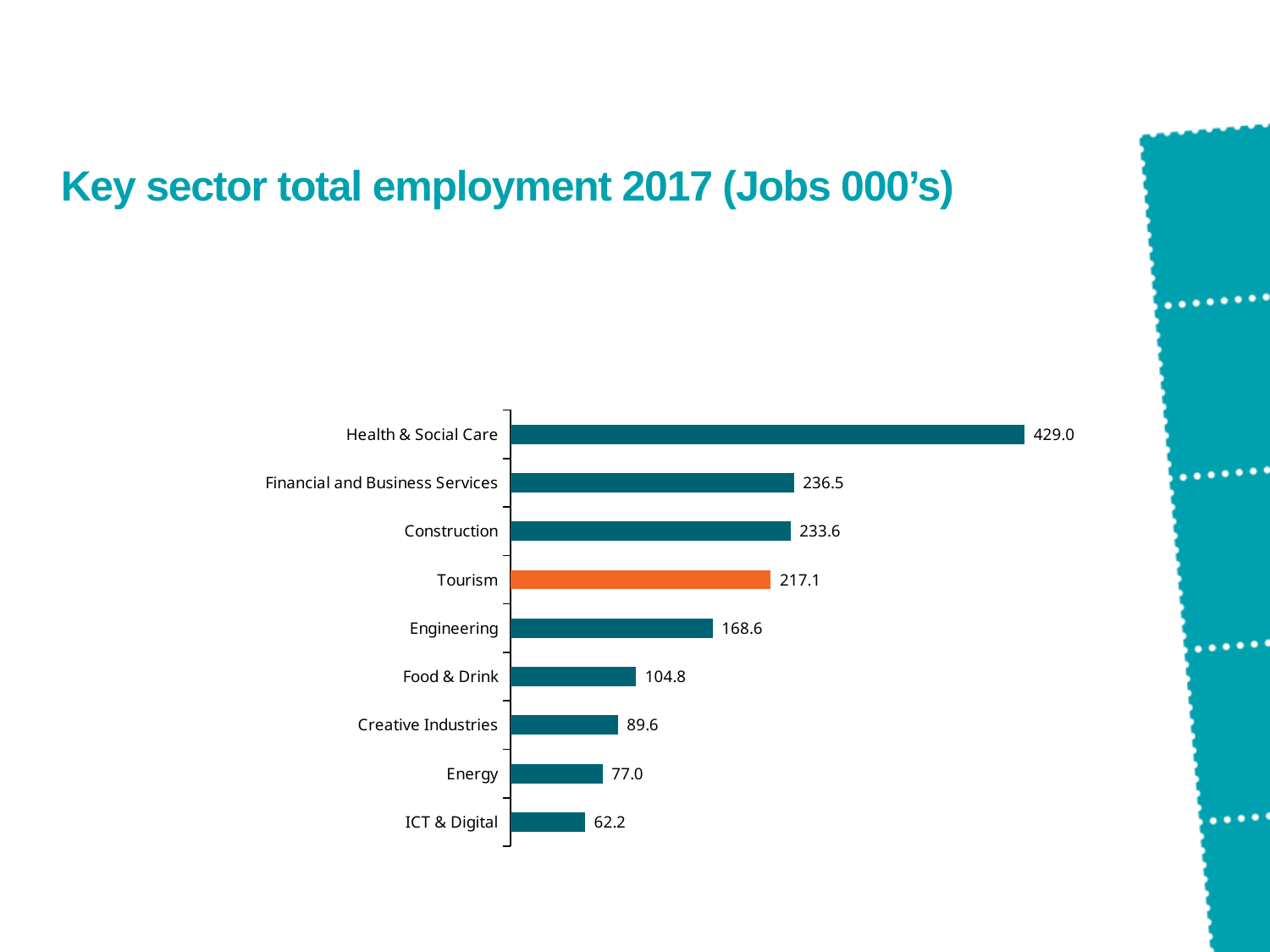
What is the difference between the values for Health & Social Care and Financial and Business Services? 192.5 What is the title of the chart? Key sector total employment 2017 (Jobs 000's) Which sector's bar is shown in orange rather than teal? Tourism Which sector has the lowest value? ICT & Digital What is the value for Energy? 77.0 What kind of chart is shown on the slide? Bar chart What is the value for Tourism? 217.1 Which is larger, the value for Engineering or the value for Food & Drink? Engineering Which sector has the highest value? Health & Social Care What is the difference between the values for Food & Drink and Creative Industries? 15.2 How many sectors are shown in the chart? 9 What is the value for Health & Social Care? 429.0